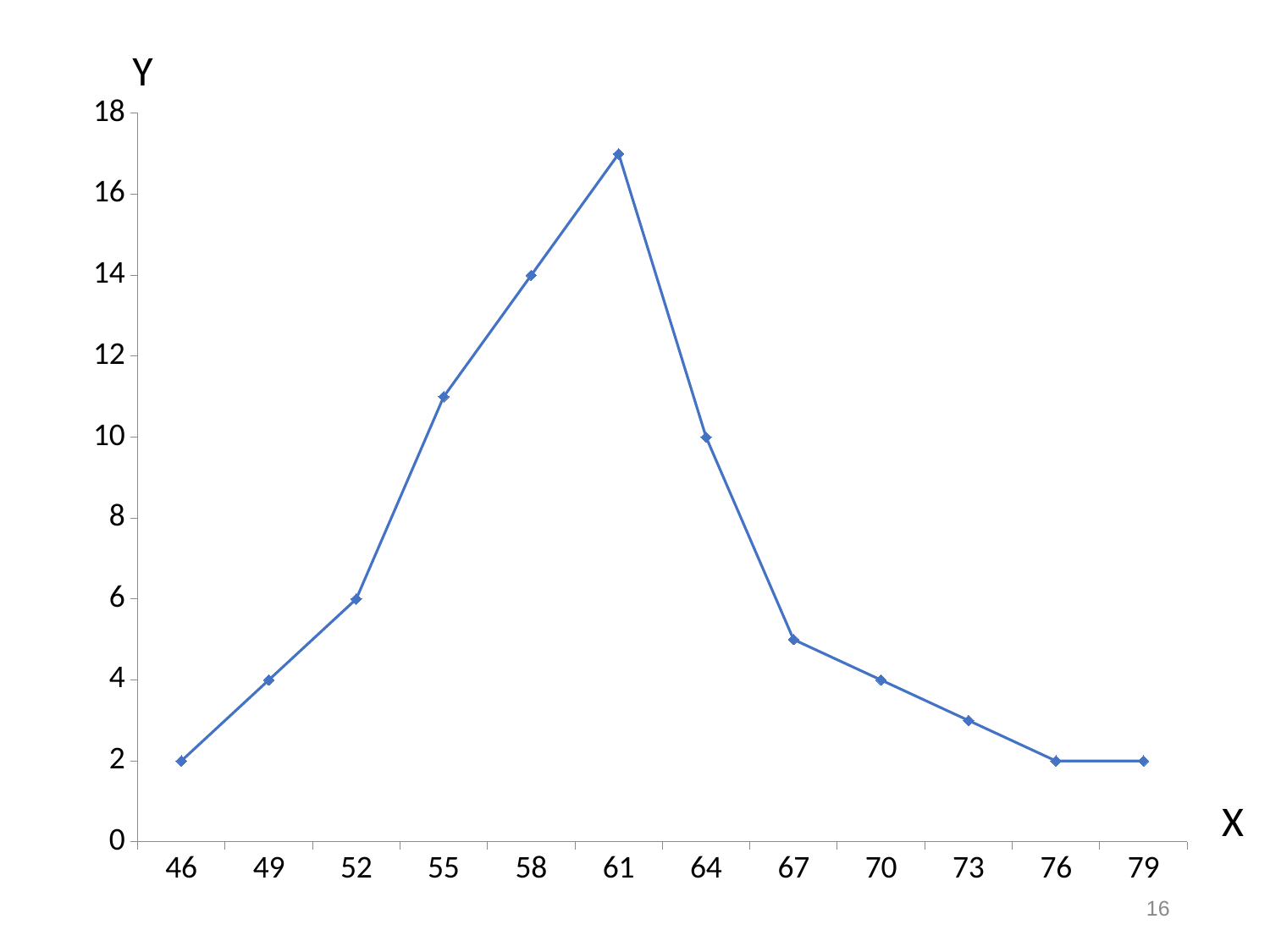
What is the difference between the Y values at X = 58 and X = 52? 8 How many data points are plotted on the line? 12 At which X value does the line reach its highest Y value? 61 What is the Y value at X = 64? 10 Is the Y value at X = 61 greater or less than 16? greater What is the Y value at X = 52? 6 Which has the larger Y value, X = 58 or X = 64? 58 What is the Y value at X = 58? 14 What is the Y value at X = 46? 2 Does the Y value rise or fall as X goes from 61 to 79? fall Is the Y value at X = 67 greater or less than 6? less What type of chart is shown on the slide? line chart